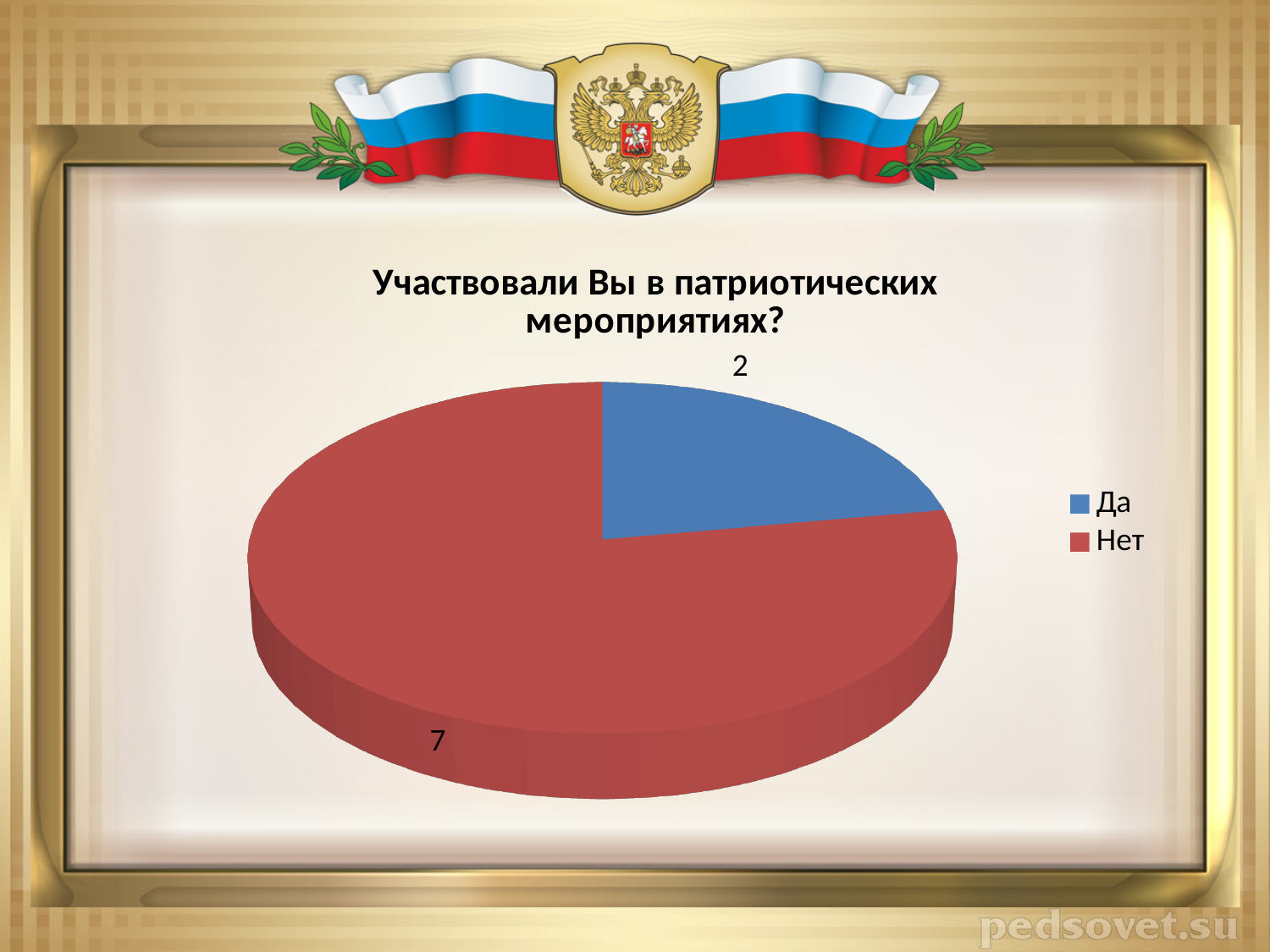
What is the difference between the values for Нет and Да? 5 What kind of chart is shown on the slide? Pie chart Which category has the smallest slice? Да Which is larger, the value for Да or the value for Нет? Нет What colour is the slice for Нет? Red Which category has the largest slice? Нет What is the value for Да? 2 What is the value for Нет? 7 How many categories does the pie chart show? 2 What is the total of all slices in the pie chart? 9 What is the title of the chart? Участвовали Вы в патриотических мероприятиях?